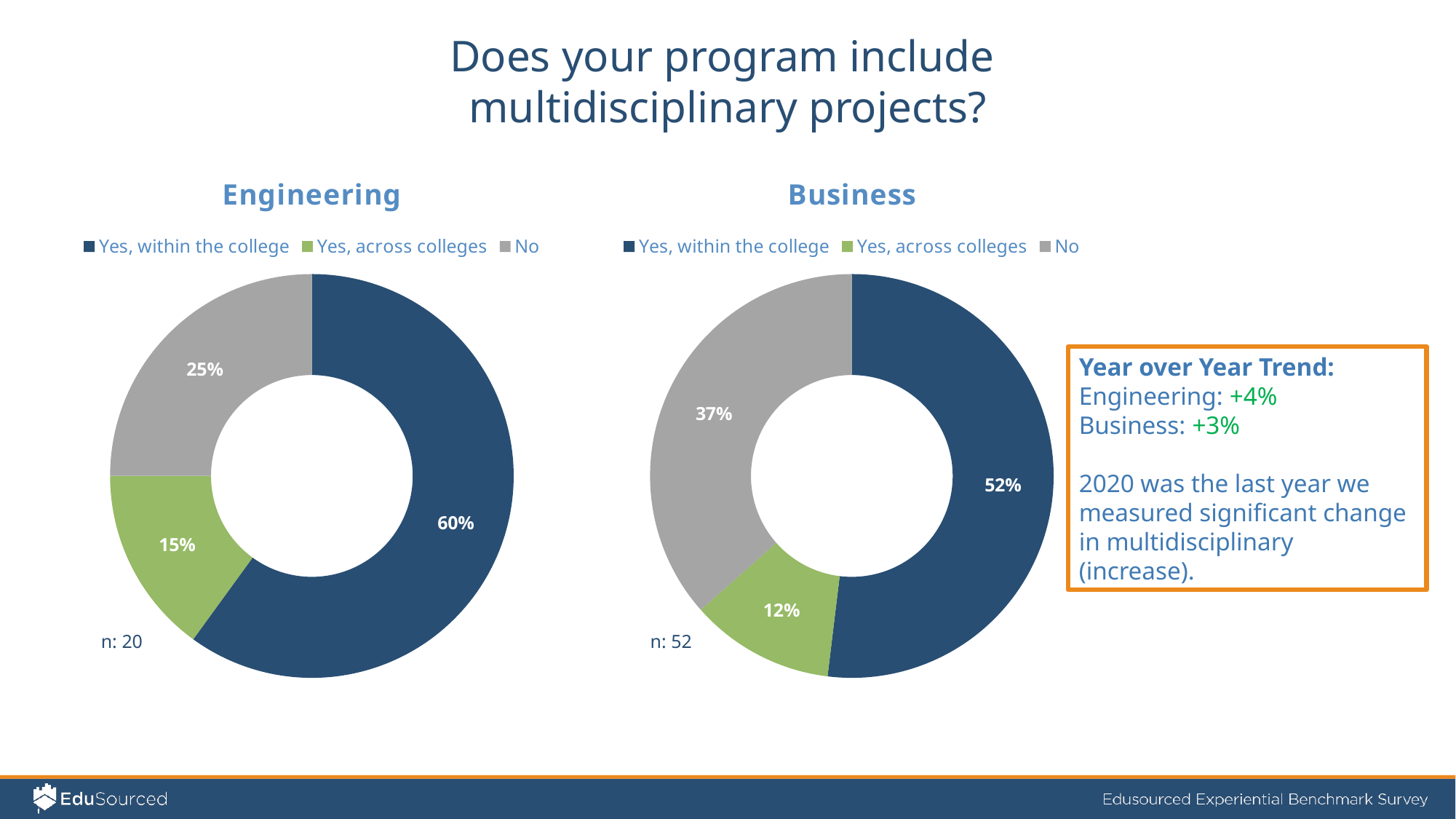
In the Engineering chart, which response has the largest share? Yes, within the college Which chart has a larger share for "Yes, within the college", Engineering or Business? Engineering How many categories does the Engineering chart show? 3 What is the difference between the "No" share in the Business chart and the "No" share in the Engineering chart? 12% In the Business chart, what percentage answered "No"? 37% What type of chart is the Business chart? Pie chart (doughnut) In the Business chart, which response has the smallest share? Yes, across colleges In the Engineering chart, what percentage answered "Yes, within the college"? 60% What is the sample size (n) shown for the Business chart? 52 In the Engineering chart, what percentage answered "Yes, across colleges"? 15% In the Business chart, what percentage answered "Yes, within the college"? 52% What colour represents "No" in the Engineering chart? Grey